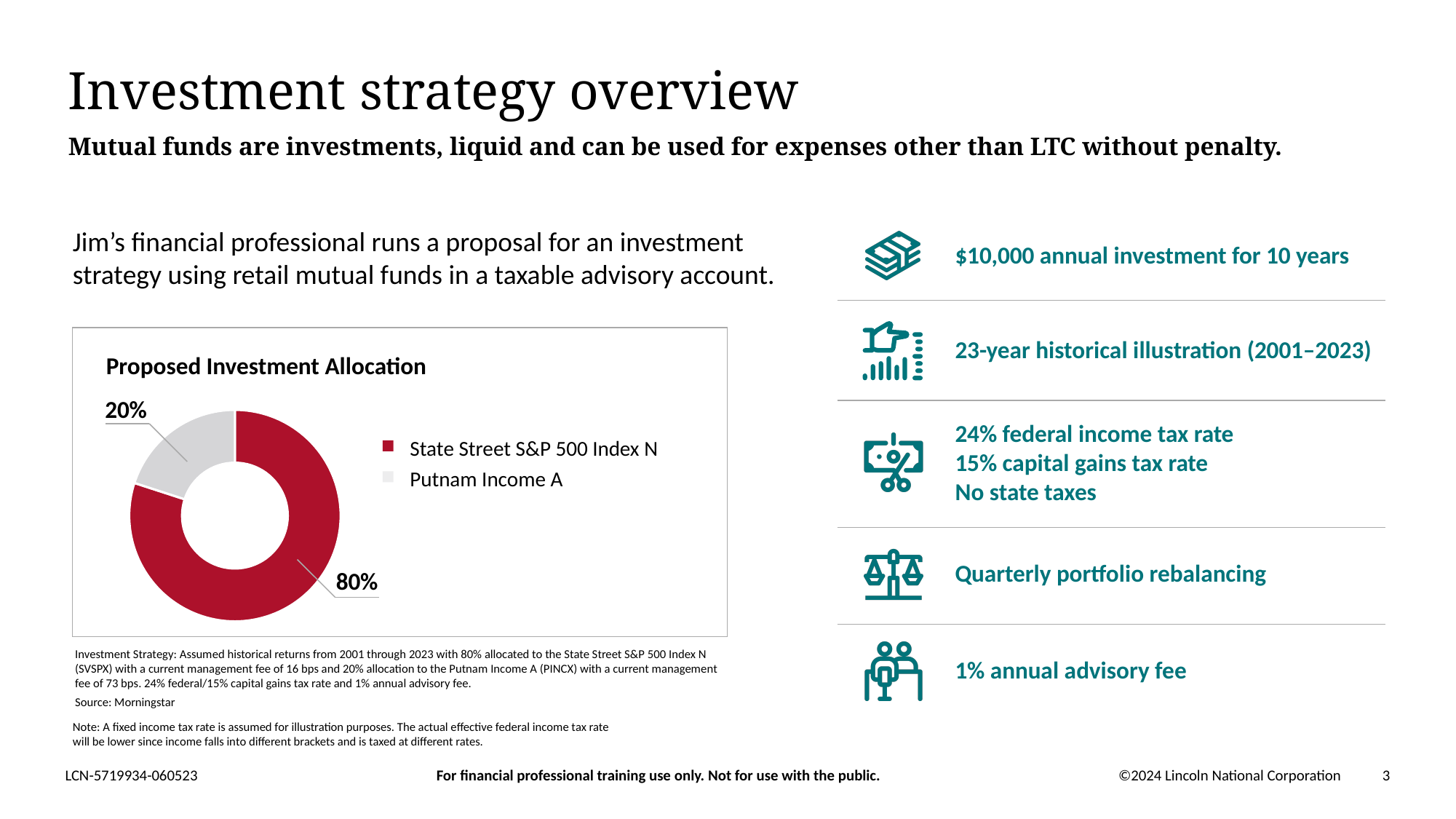
Which fund has the smallest share of the proposed allocation? Putnam Income A How many categories does the Proposed Investment Allocation chart show? 2 What share of the allocation is Putnam Income A? 20% Which fund has the largest share of the proposed allocation? State Street S&P 500 Index N What colour represents State Street S&P 500 Index N in the chart? Red What share of the allocation is State Street S&P 500 Index N? 80% What kind of chart is the Proposed Investment Allocation chart? Doughnut chart How many entries does the chart legend list? 2 Which is larger: the share for State Street S&P 500 Index N or the share for Putnam Income A? State Street S&P 500 Index N What is the difference in percentage points between the State Street S&P 500 Index N share and the Putnam Income A share? 60 percentage points What is the title of the chart on the slide? Proposed Investment Allocation